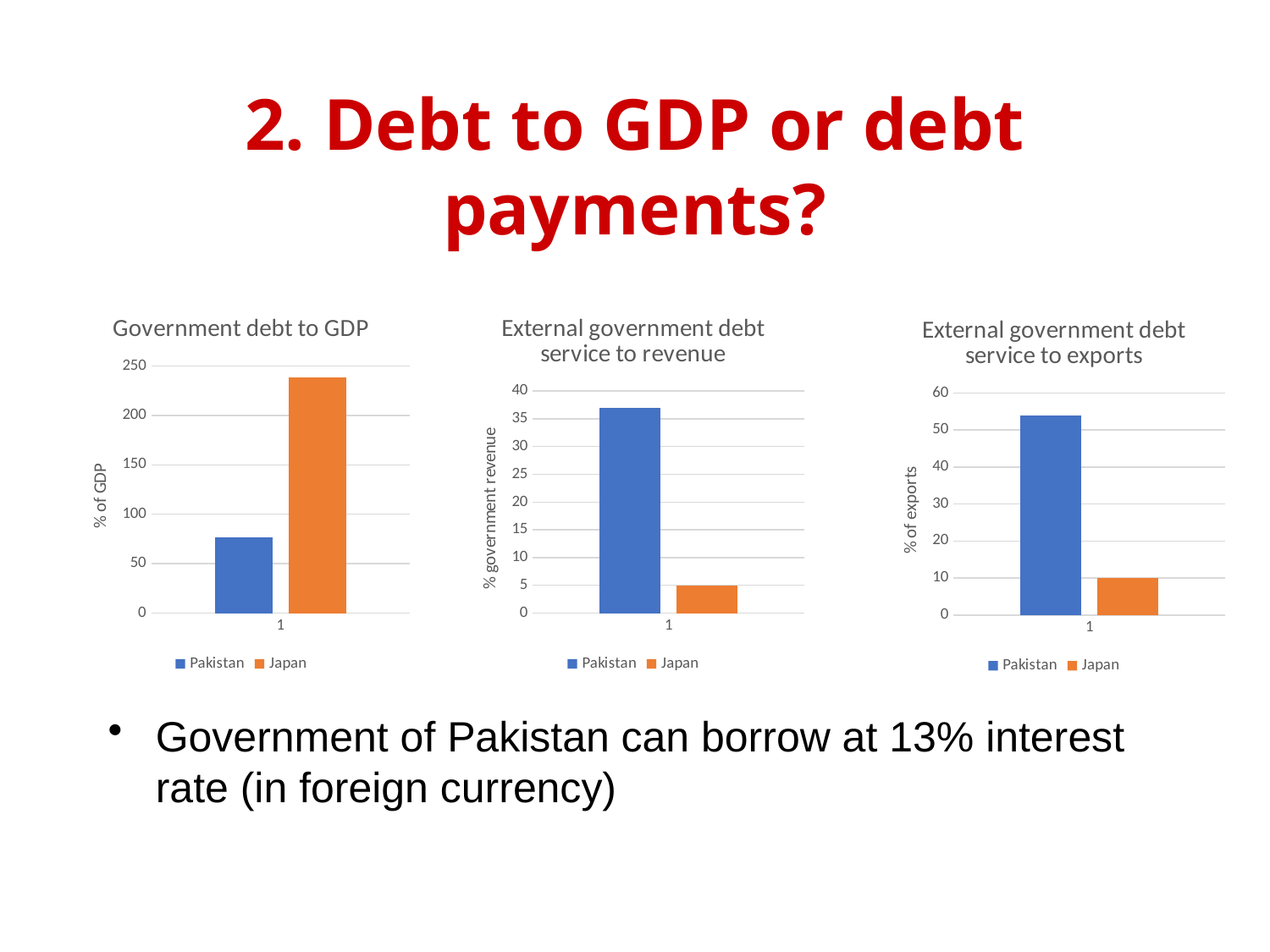
In the 'External government debt service to revenue' chart, is the value for Japan greater or less than 10? less What is the y-axis label of the 'External government debt service to exports' chart? % of exports What kind of chart is the 'Government debt to GDP' chart? Bar chart In the 'External government debt service to exports' chart, which series has the higher value, Pakistan or Japan? Pakistan In the 'External government debt service to exports' chart, is the value for Japan greater or less than 20? less In the 'External government debt service to exports' chart, is the value for Pakistan greater or less than 50? greater In the 'External government debt service to revenue' chart, which series has the higher value, Pakistan or Japan? Pakistan In the 'Government debt to GDP' chart, which series has the higher value, Pakistan or Japan? Japan How many series does the legend of the 'External government debt service to revenue' chart list? 2